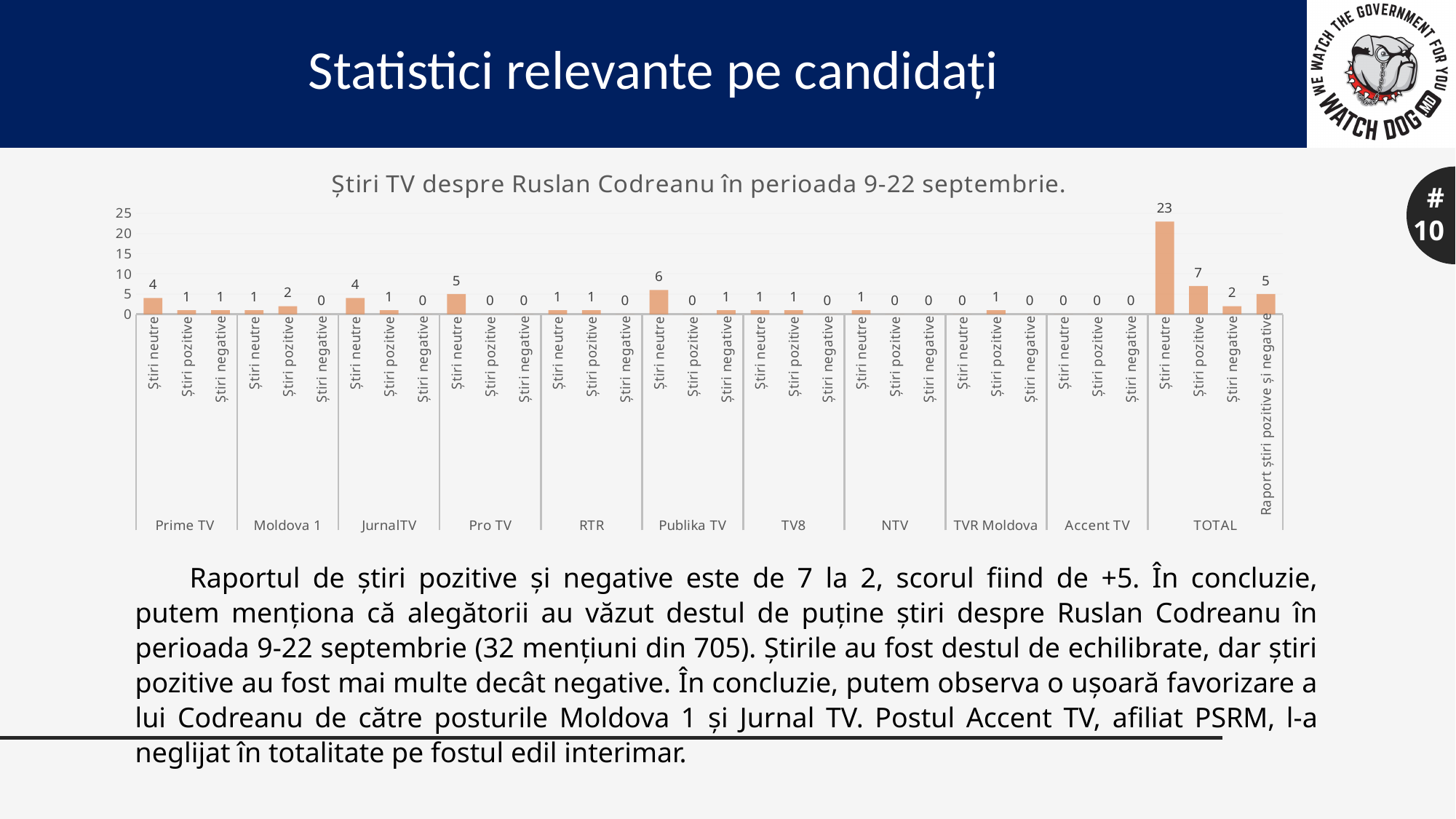
Which bar has the highest value on the chart? Știri neutre (TOTAL) What is the value for Știri negative in the TOTAL group? 2 Which is larger: Știri neutre at Pro TV or Știri neutre at JurnalTV? Știri neutre at Pro TV What is the value for Știri pozitive in the TOTAL group? 7 What is the value for Raport știri pozitive și negative in the TOTAL group? 5 Is the value for Știri neutre in the TOTAL group greater or less than 20? greater What is the value for Știri pozitive at Moldova 1? 2 What is the difference between Știri neutre at Pro TV and Știri neutre at Prime TV? 1 What type of chart is shown on the slide? Bar chart How many TV station groups (including TOTAL) are shown on the x axis? 11 Excluding the TOTAL group, which TV station has the highest value for Știri neutre? Publika TV What is the value for Știri neutre at Publika TV? 6